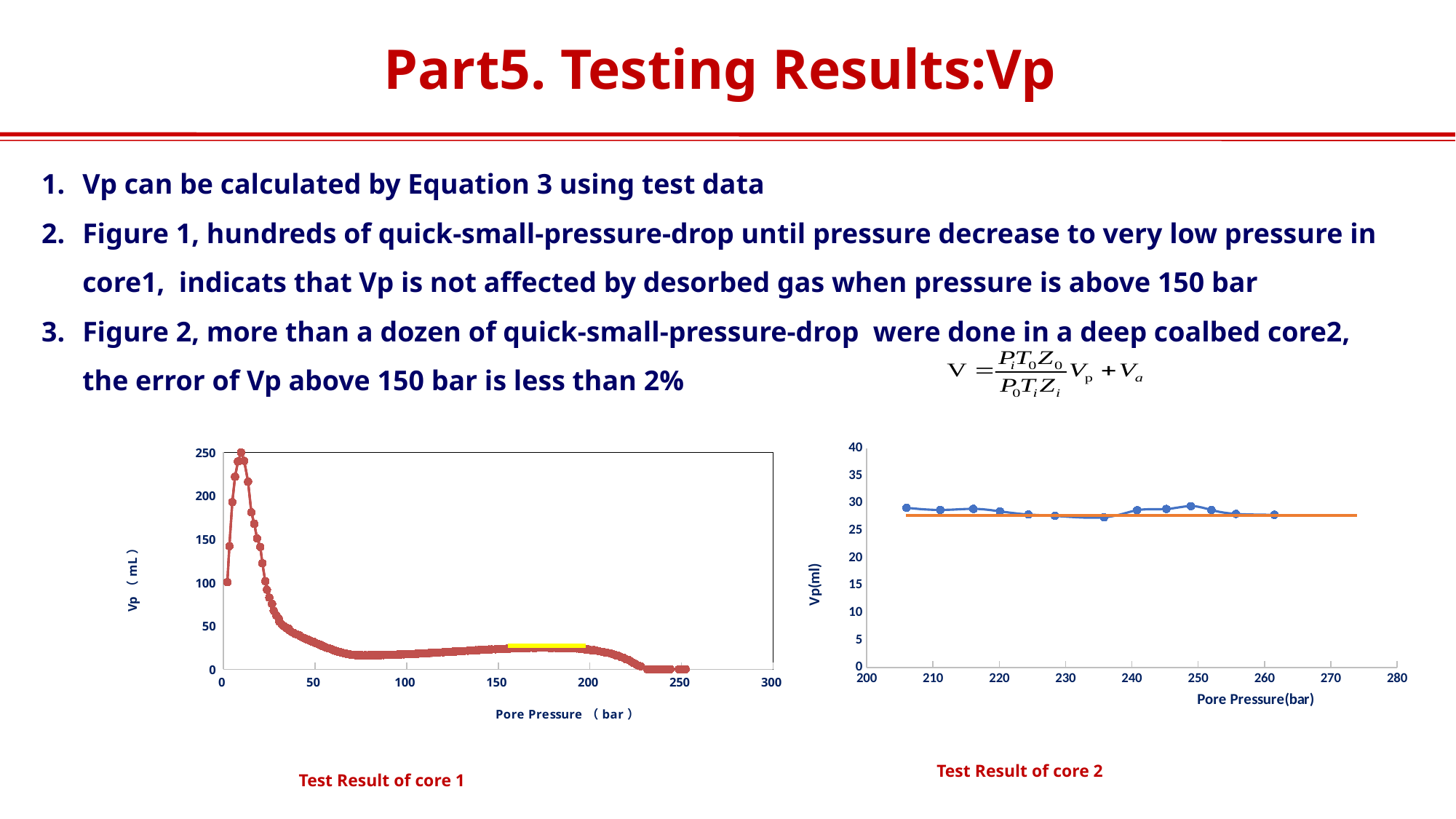
What is the x-axis label of the 'Test Result of core 2' chart? Pore Pressure(bar) In the 'Test Result of core 1' chart, is the peak Vp value greater or less than 200? greater What is the y-axis label of the 'Test Result of core 1' chart? Vp (mL) In the 'Test Result of core 2' chart, are all the plotted Vp values greater or less than 35? less In the 'Test Result of core 1' chart, does Vp rise or fall as pore pressure increases from 200 bar to 250 bar? fall What kind of chart is the 'Test Result of core 2' chart on the right? line chart In the 'Test Result of core 2' chart, do the Vp values show a strong rise, a strong fall, or stay roughly flat as pore pressure increases? roughly flat In the 'Test Result of core 2' chart, is the Vp value at a pore pressure of about 206 bar greater or less than 20? greater What kind of chart is the 'Test Result of core 1' chart on the left? line chart